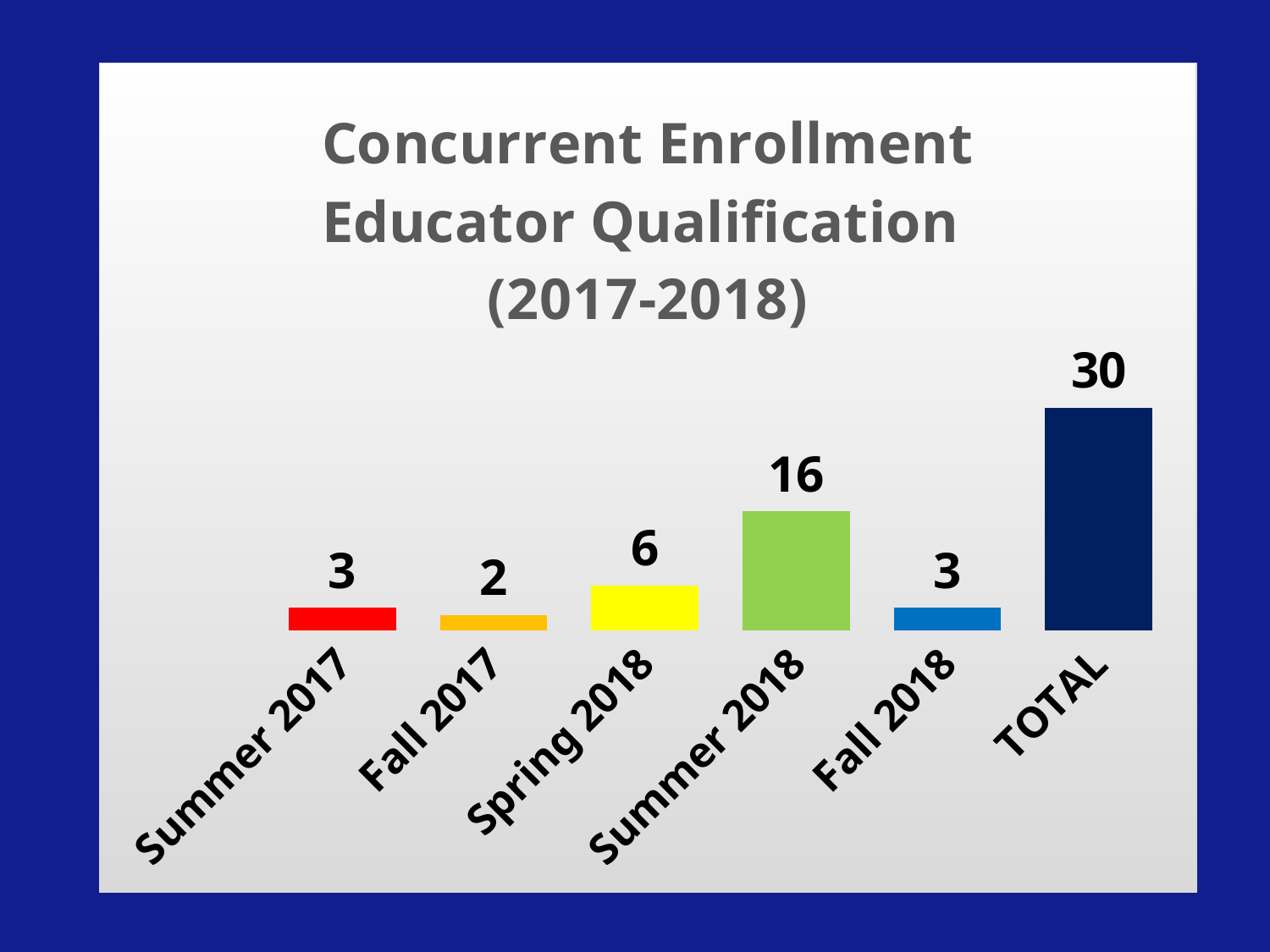
What is the difference between the values for Summer 2018 and Spring 2018? 10 What kind of chart is shown on the slide? bar chart Excluding the TOTAL bar, which category has the highest value? Summer 2018 Which category has the lowest value? Fall 2017 Which is larger, the value for Spring 2018 or the value for Fall 2018? Spring 2018 What is the value shown for TOTAL? 30 How many bars are shown in the chart? 6 What colour is the Summer 2018 bar? green What is the value for Fall 2017? 2 What is the title of the chart? Concurrent Enrollment Educator Qualification (2017-2018) What is the value for Summer 2018? 16 What is the value for Spring 2018? 6